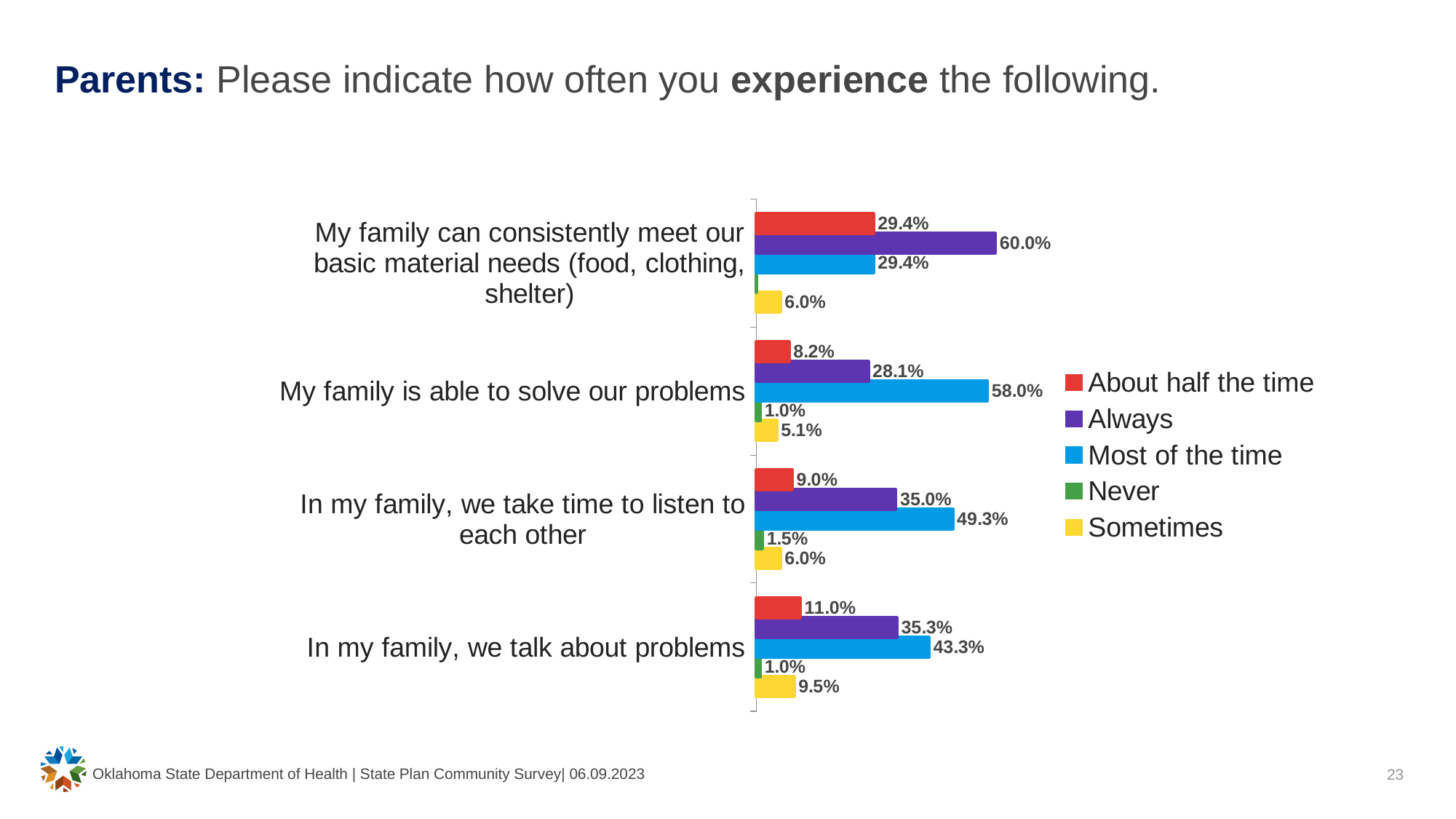
What is the 'Sometimes' value for 'In my family, we talk about problems'? 9.5% How many series does the legend list? 5 What is the difference between the 'Most of the time' values for 'In my family, we take time to listen to each other' and 'In my family, we talk about problems'? 6.0% How many statements (categories) are plotted on the chart? 4 What is the 'Most of the time' value for 'My family is able to solve our problems'? 58.0% Which legend entry is shown in green? Never What is the 'About half the time' value for 'In my family, we take time to listen to each other'? 9.0% What is the 'Always' value for 'My family can consistently meet our basic material needs (food, clothing, shelter)'? 60.0% What kind of chart is shown on the slide? Bar chart Which statement has the lowest 'Most of the time' value? My family can consistently meet our basic material needs (food, clothing, shelter) Which statement has the highest 'Always' value? My family can consistently meet our basic material needs (food, clothing, shelter) Which is larger for 'In my family, we talk about problems': the 'Always' value or the 'Most of the time' value? Most of the time